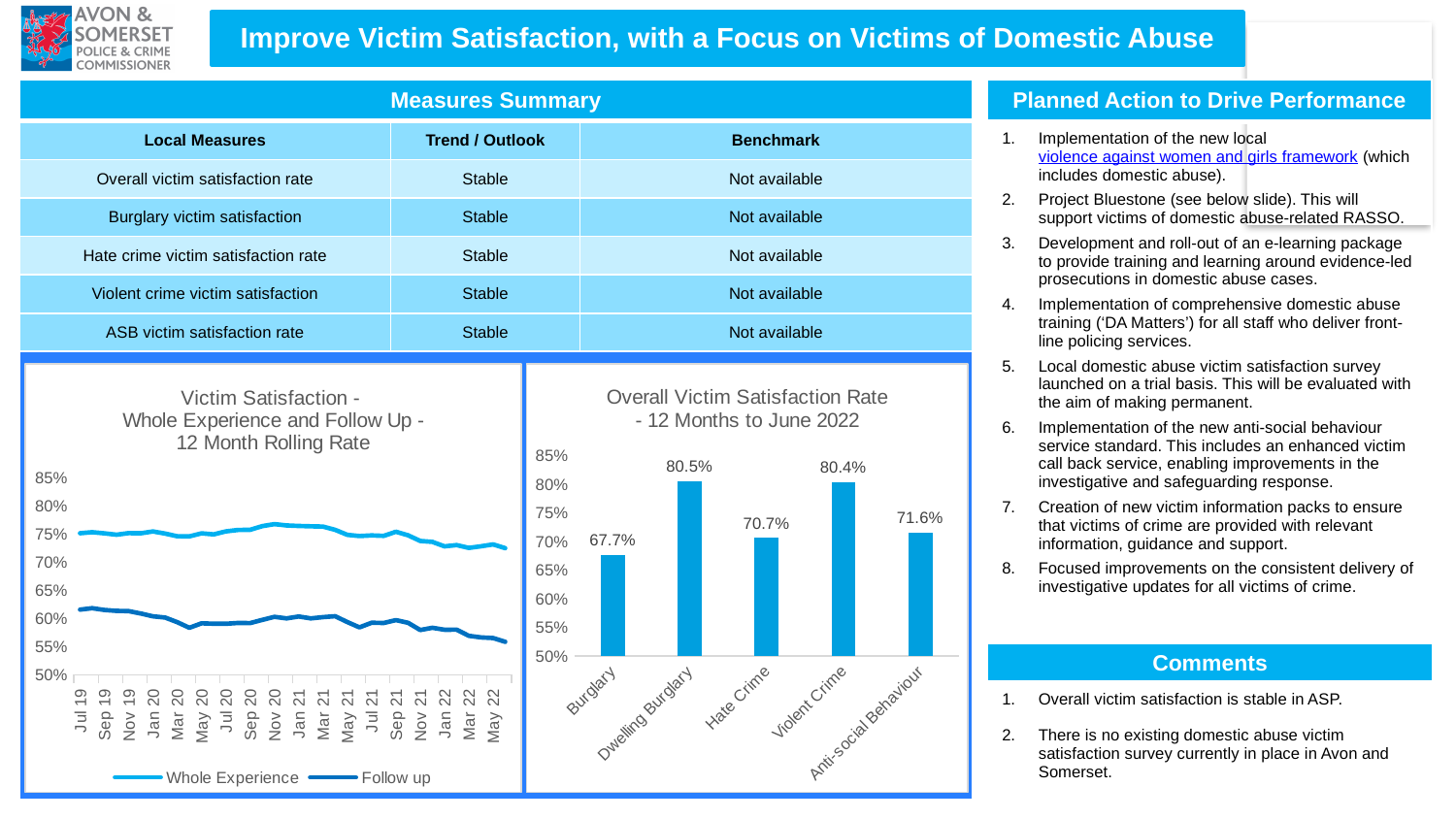
How many categories are shown in the Overall Victim Satisfaction Rate chart? 5 In the Victim Satisfaction - Whole Experience and Follow Up chart, is the Follow up value at May 22 greater or less than 60%? less In the Overall Victim Satisfaction Rate chart, which category has the lowest satisfaction rate? Burglary In the Overall Victim Satisfaction Rate chart, what is the value for Burglary? 67.7% In the Overall Victim Satisfaction Rate chart, which is larger, Hate Crime or Burglary? Hate Crime In the Victim Satisfaction - Whole Experience and Follow Up chart, is the Whole Experience value at Jul 19 greater or less than 70%? greater In the Overall Victim Satisfaction Rate chart, what is the difference between Dwelling Burglary and Burglary? 12.8 percentage points In the Victim Satisfaction - Whole Experience and Follow Up chart, does the Follow up series rise or fall overall from Jul 19 to May 22? Fall In the Overall Victim Satisfaction Rate chart, what is the value for Dwelling Burglary? 80.5% How many series does the legend of the Victim Satisfaction - Whole Experience and Follow Up chart list? 2 In the Overall Victim Satisfaction Rate chart, what is the value for Anti-social Behaviour? 71.6% What kind of chart is the Overall Victim Satisfaction Rate chart? Bar chart